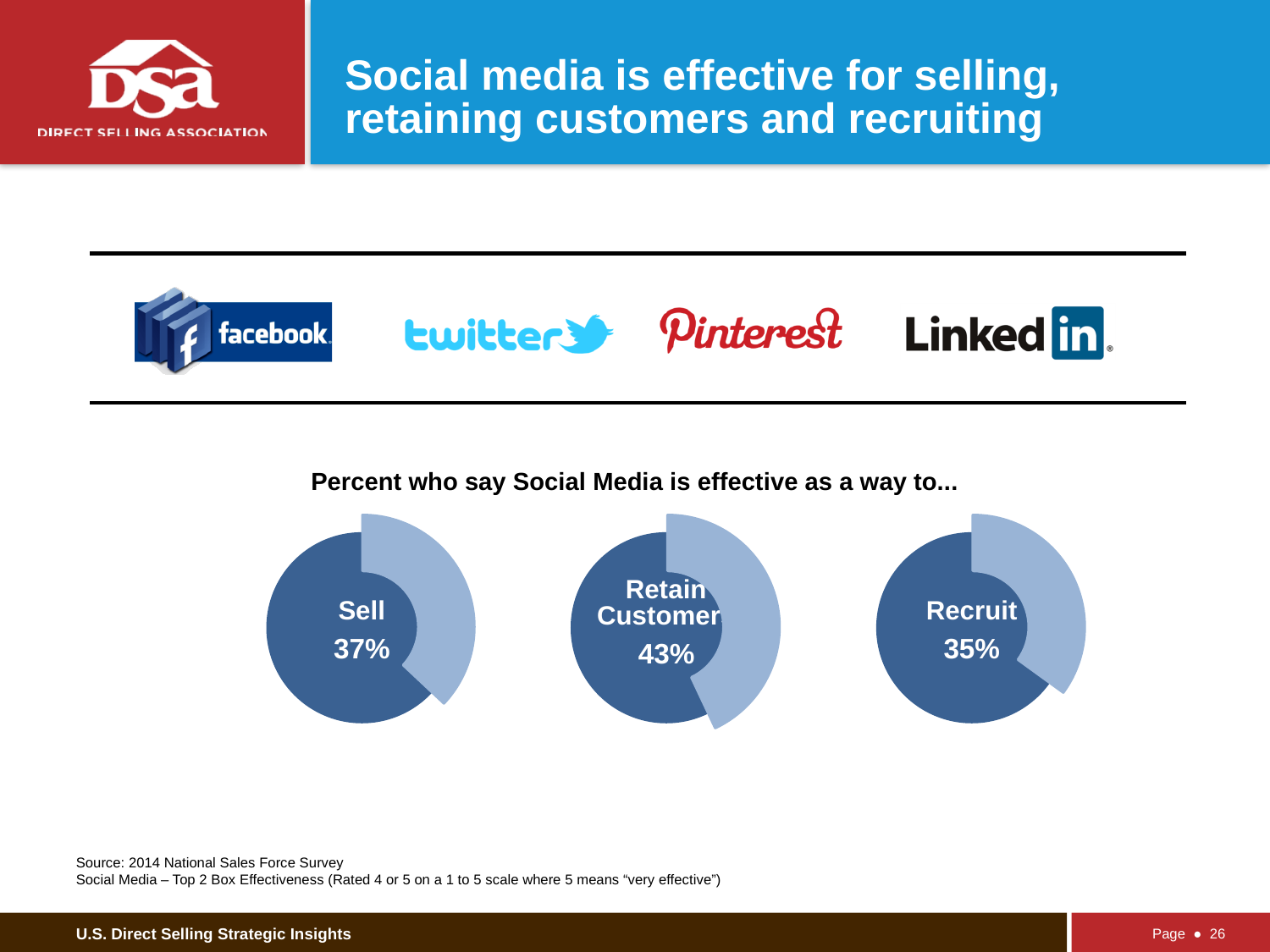
What percent say social media is effective as a way to sell? 37% Which of the three uses (Sell, Retain Customer, Recruit) has the highest percentage? Retain Customer What kind of chart is used to show the percentages for Sell, Retain Customer and Recruit? Pie (donut) chart What percent say social media is effective as a way to recruit? 35% What is the difference in percentage points between Retain Customer and Sell? 6 Which of the three uses (Sell, Retain Customer, Recruit) has the lowest percentage? Recruit What is the difference in percentage points between Sell and Recruit? 2 What percent say social media is effective as a way to retain customers? 43% Which is larger, the percentage for Retain Customer or the percentage for Recruit? Retain Customer How many donut charts are shown on the slide? 3 Which is larger, the percentage for Sell or the percentage for Recruit? Sell What is the title above the three charts? Percent who say Social Media is effective as a way to...